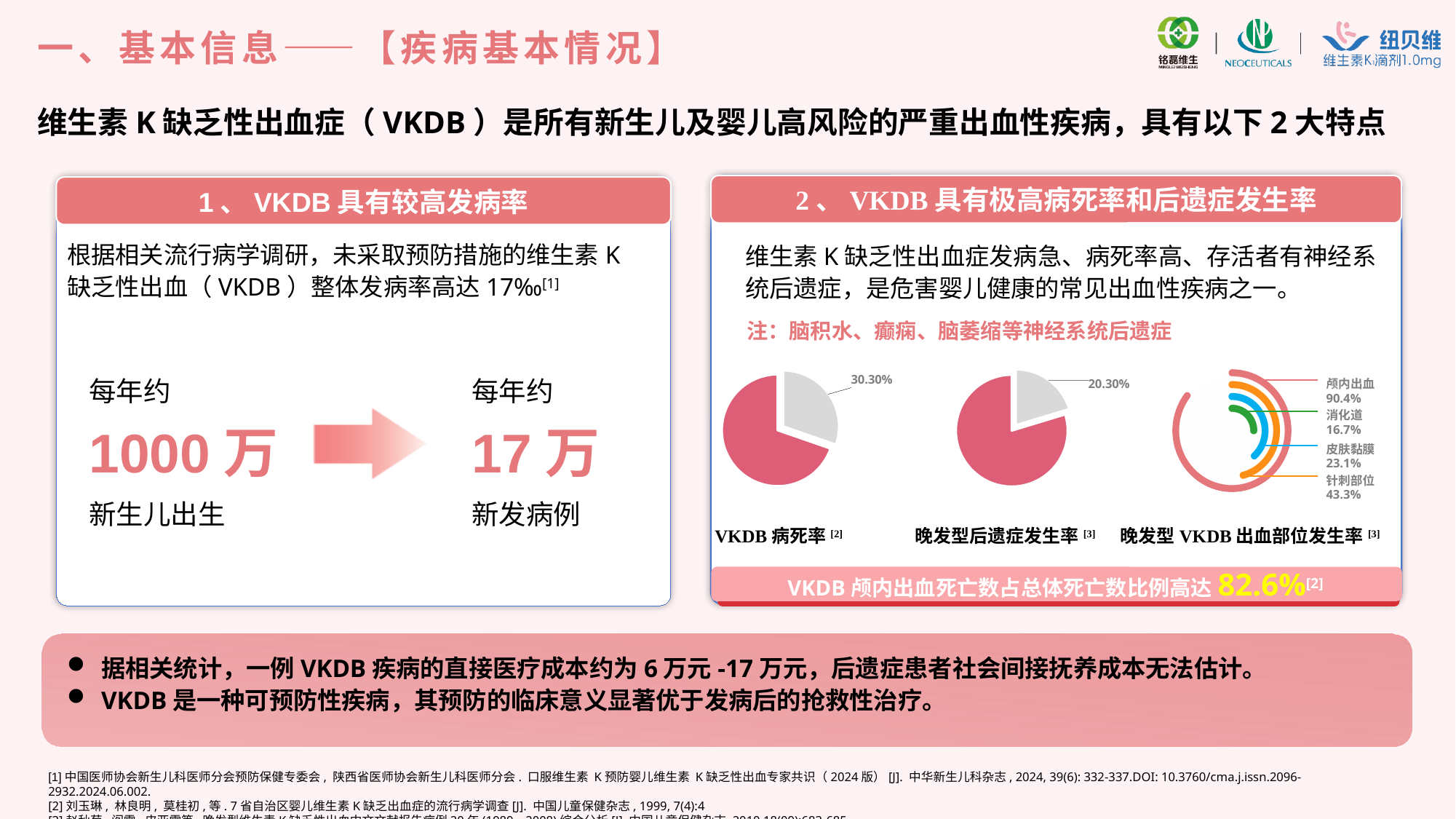
In the chart titled "VKDB 病死率", what value is labeled on the pie? 30.30% In the chart titled "晚发型 VKDB 出血部位发生率", what is the value for 颅内出血? 90.4% In the chart titled "晚发型 VKDB 出血部位发生率", which is larger, 皮肤黏膜 or 消化道? 皮肤黏膜 In the chart titled "晚发型 VKDB 出血部位发生率", what is the difference between the values for 颅内出血 and 针刺部位? 47.1% In the chart titled "晚发型 VKDB 出血部位发生率", how many categories are shown? 4 In the chart titled "晚发型 VKDB 出血部位发生率", what is the value for 针刺部位? 43.3% What kind of chart is the one titled "VKDB 病死率"? Pie chart In the chart titled "晚发型 VKDB 出血部位发生率", what is the value for 皮肤黏膜? 23.1% In the chart titled "晚发型 VKDB 出血部位发生率", which category has the highest value? 颅内出血 In the chart titled "晚发型 VKDB 出血部位发生率", what is the value for 消化道? 16.7% In the chart titled "晚发型后遗症发生率", what value is labeled on the pie? 20.30% In the chart titled "晚发型 VKDB 出血部位发生率", which category has the lowest value? 消化道